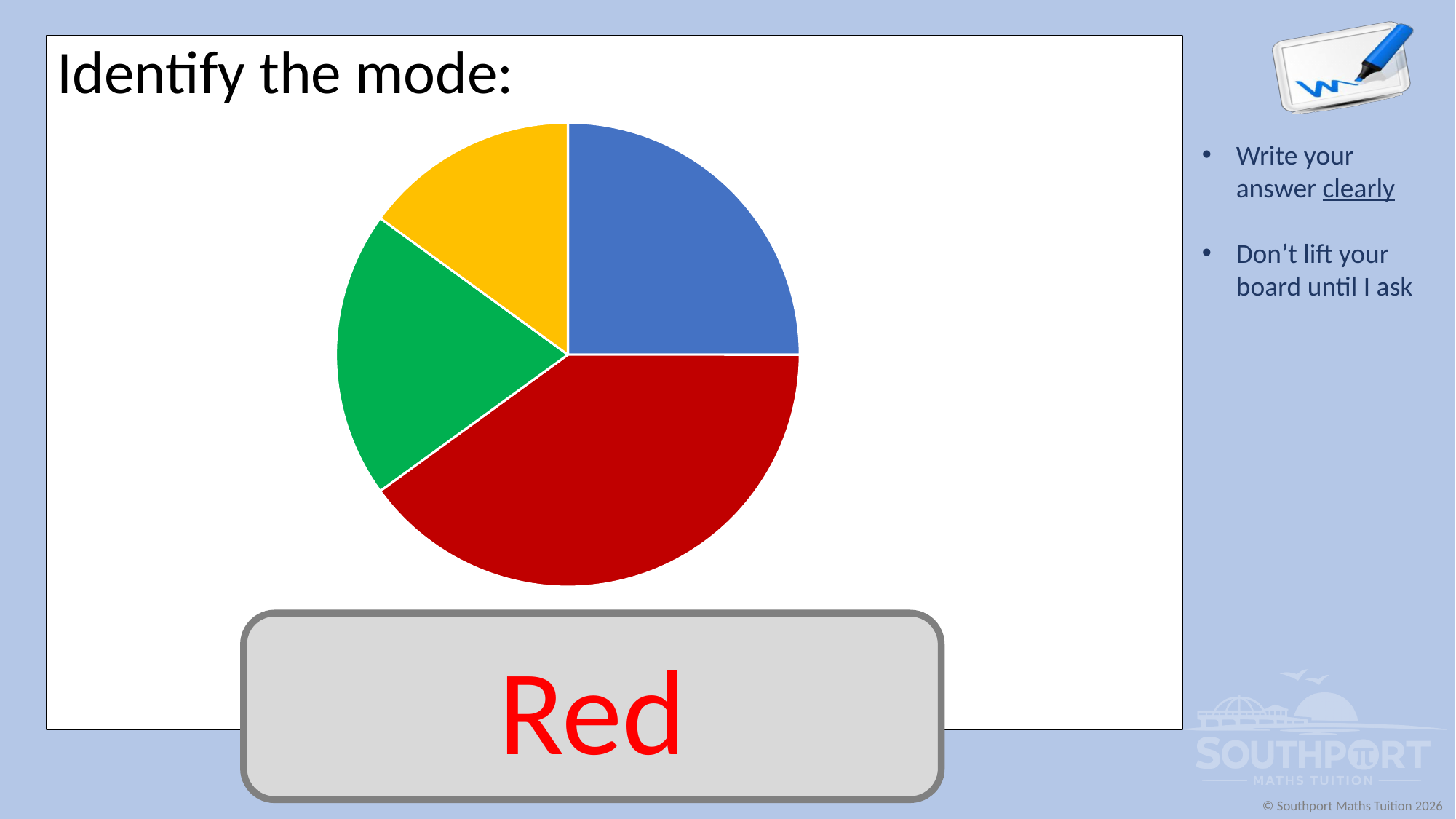
Which colour slice is the smallest in the pie chart? yellow Which slice is larger, the blue slice or the green slice? blue What is the heading above the pie chart? Identify the mode: Which slice is larger, the red slice or the blue slice? red What is the mode identified on the slide? Red What kind of chart is shown on the slide? pie chart Which slice is larger, the green slice or the yellow slice? green Which colour slice is the largest in the pie chart? red How many slices does the pie chart have? 4